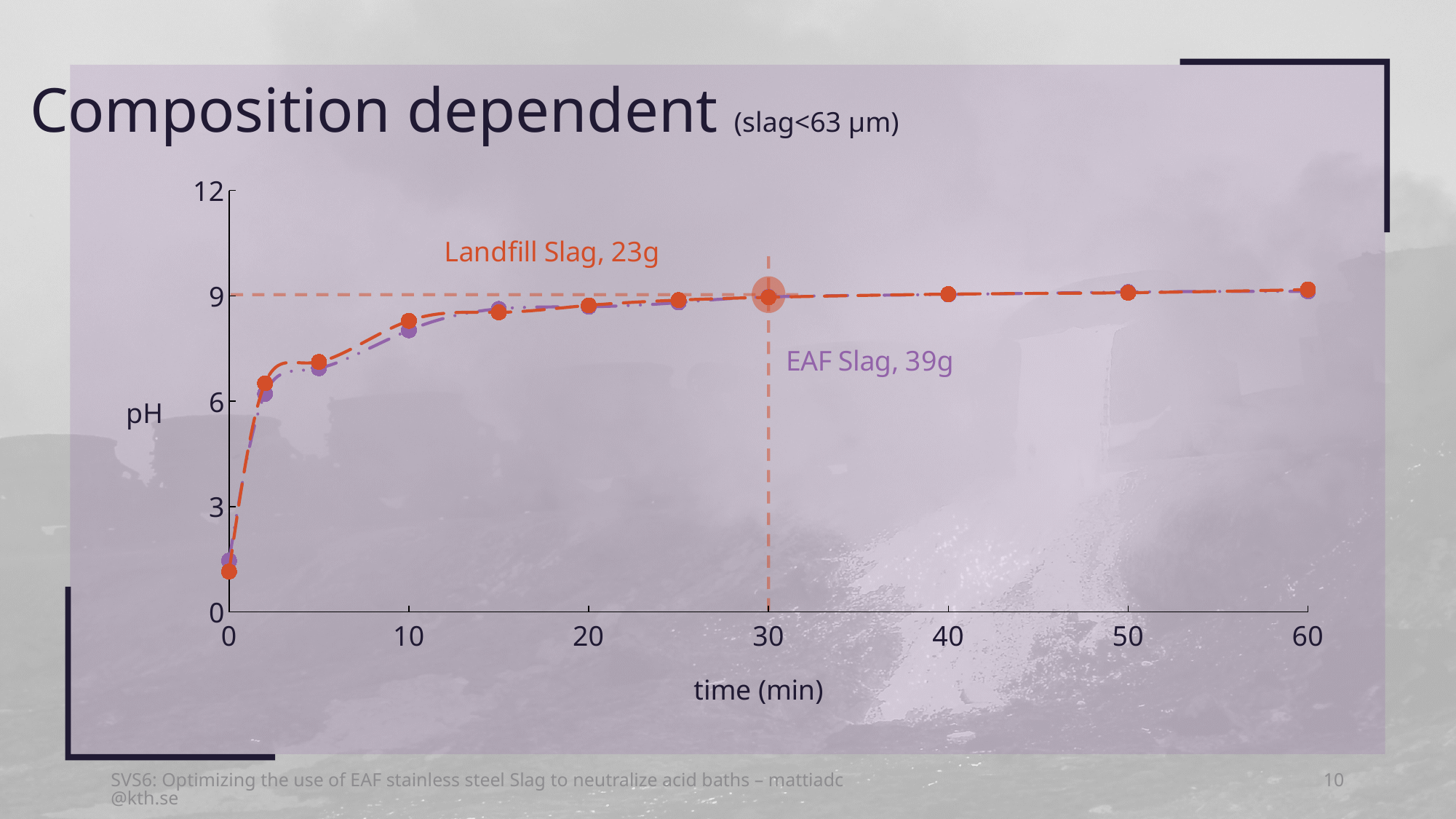
How many series are plotted on the chart? 2 Is the pH for Landfill Slag, 23g at 10 min greater or less than 9? less At 10 min, which series has the higher pH, Landfill Slag, 23g or EAF Slag, 39g? Landfill Slag, 23g Is the pH for EAF Slag, 39g at 60 min greater or less than 6? greater How many data points are plotted for the Landfill Slag, 23g series? 11 What is the label of the y axis? pH Is the pH for Landfill Slag, 23g at 0 min greater or less than 3? less What are the names of the two series plotted on the chart? Landfill Slag, 23g and EAF Slag, 39g At 2 min, which series has the higher pH, Landfill Slag, 23g or EAF Slag, 39g? Landfill Slag, 23g Does the pH for Landfill Slag, 23g rise or fall as time increases? rise What kind of chart is shown on the slide? line chart